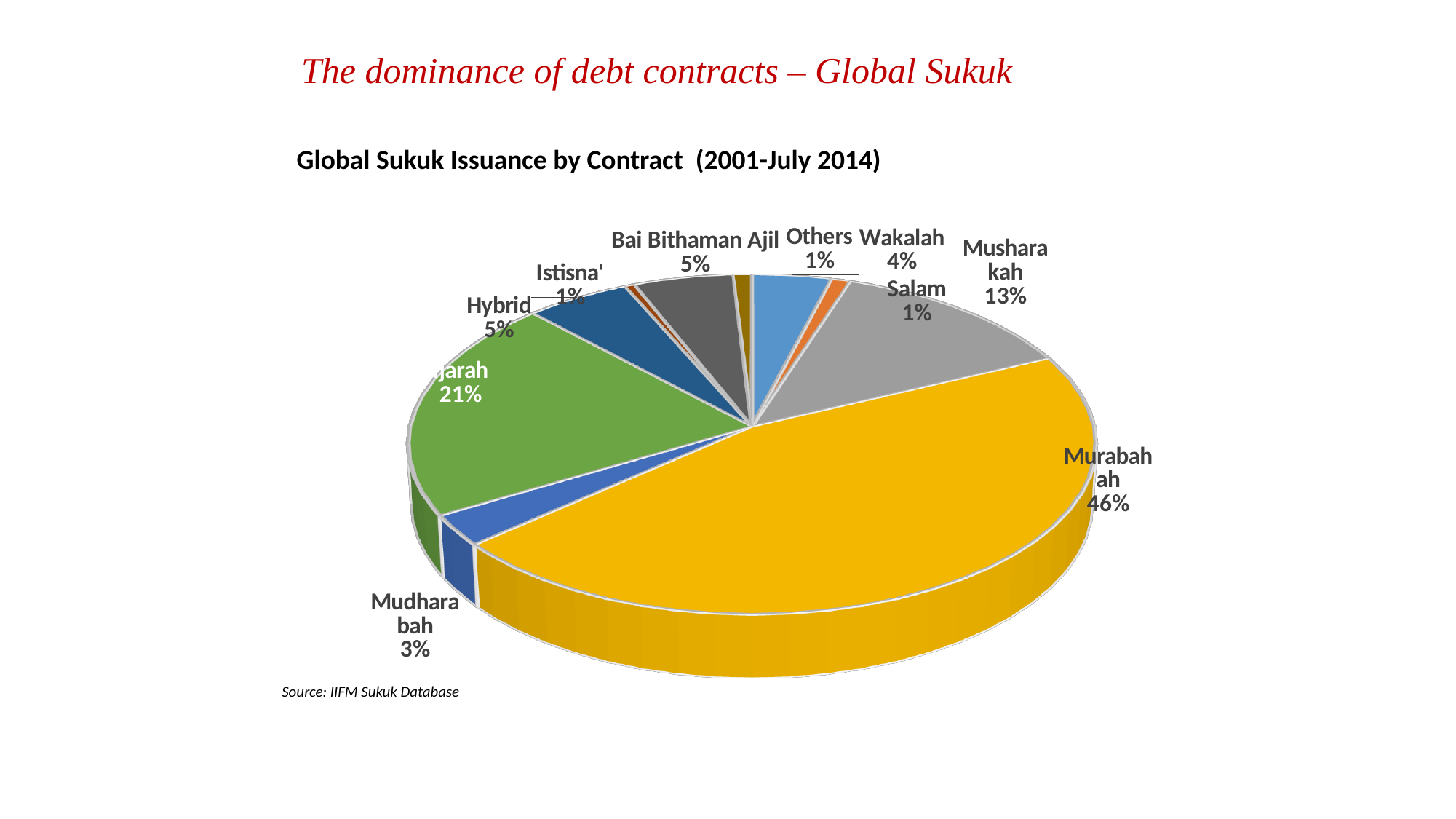
How many percentage points larger is the Murabahah share than the Musharakah share? 33 percentage points What is the title of the chart? Global Sukuk Issuance by Contract (2001-July 2014) What kind of chart is shown on the slide? Pie chart What share of global sukuk issuance is Wakalah? 4% Which has the larger share, Hybrid or Wakalah? Hybrid What share of global sukuk issuance is Murabahah? 46% How many contract types (slices) are shown in the pie chart? 10 What share of global sukuk issuance is Bai Bithaman Ajil? 5% What source is cited for the chart data? IIFM Sukuk Database Which contract type has the largest share of global sukuk issuance? Murabahah What share of global sukuk issuance is Mudharabah? 3% What share of global sukuk issuance is Musharakah? 13%